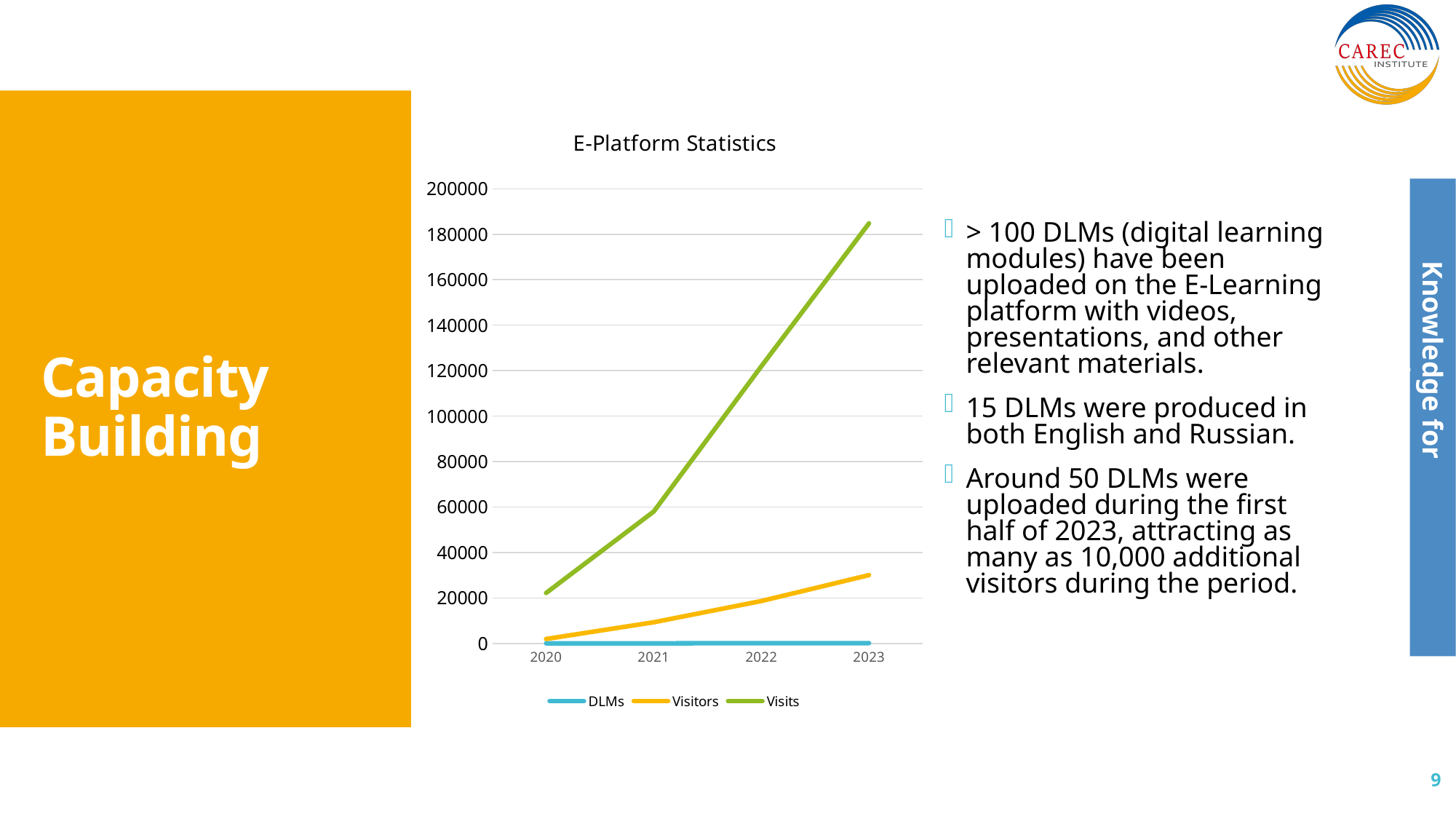
Do the Visits values rise or fall from 2020 to 2023? rise How many years are shown on the x axis? 4 Which series has the highest value in 2023? Visits How many series does the legend list? 3 Is the value for Visits in 2023 greater or less than 160000? greater Which series has the lowest values across all years? DLMs Is the value for Visitors in 2023 greater or less than 20000? greater Is the value for Visits in 2022 greater or less than 100000? greater Which is larger in 2022, Visits or Visitors? Visits What type of chart is shown on the slide? line chart What is the title of the chart? E-Platform Statistics